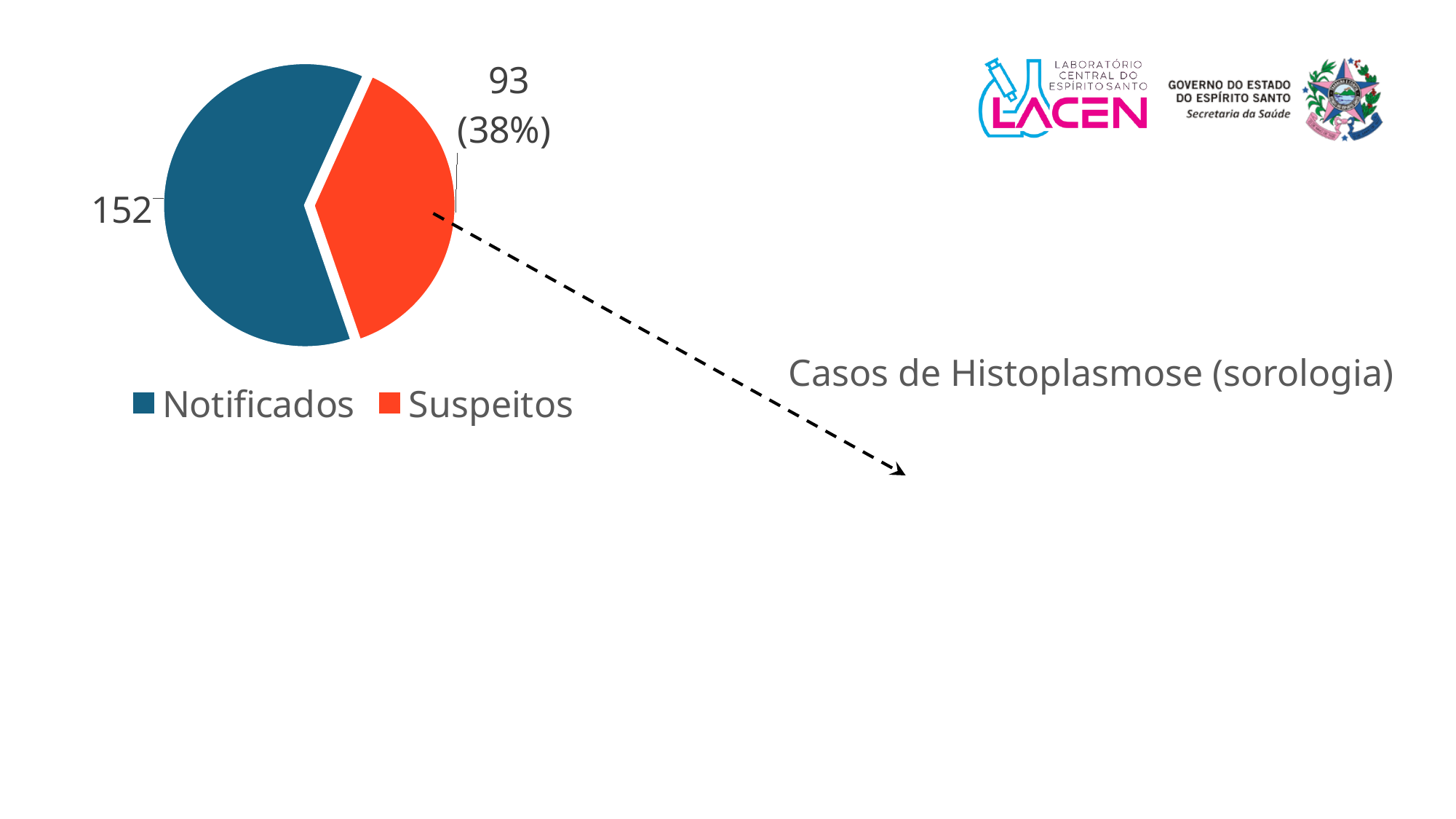
Which is larger, Notificados or Suspeitos? Notificados What is the difference between the Notificados and Suspeitos values? 59 How many entries does the legend list? 2 What colour is the Suspeitos slice? orange-red Which category has the smallest slice? Suspeitos What percentage share is shown for the Suspeitos slice? 38% Which category has the largest slice? Notificados What is the value for Notificados? 152 How many categories does the pie chart have? 2 What is the total of the two slices in the pie chart? 245 What is the value for Suspeitos? 93 What kind of chart is shown on the slide? pie chart